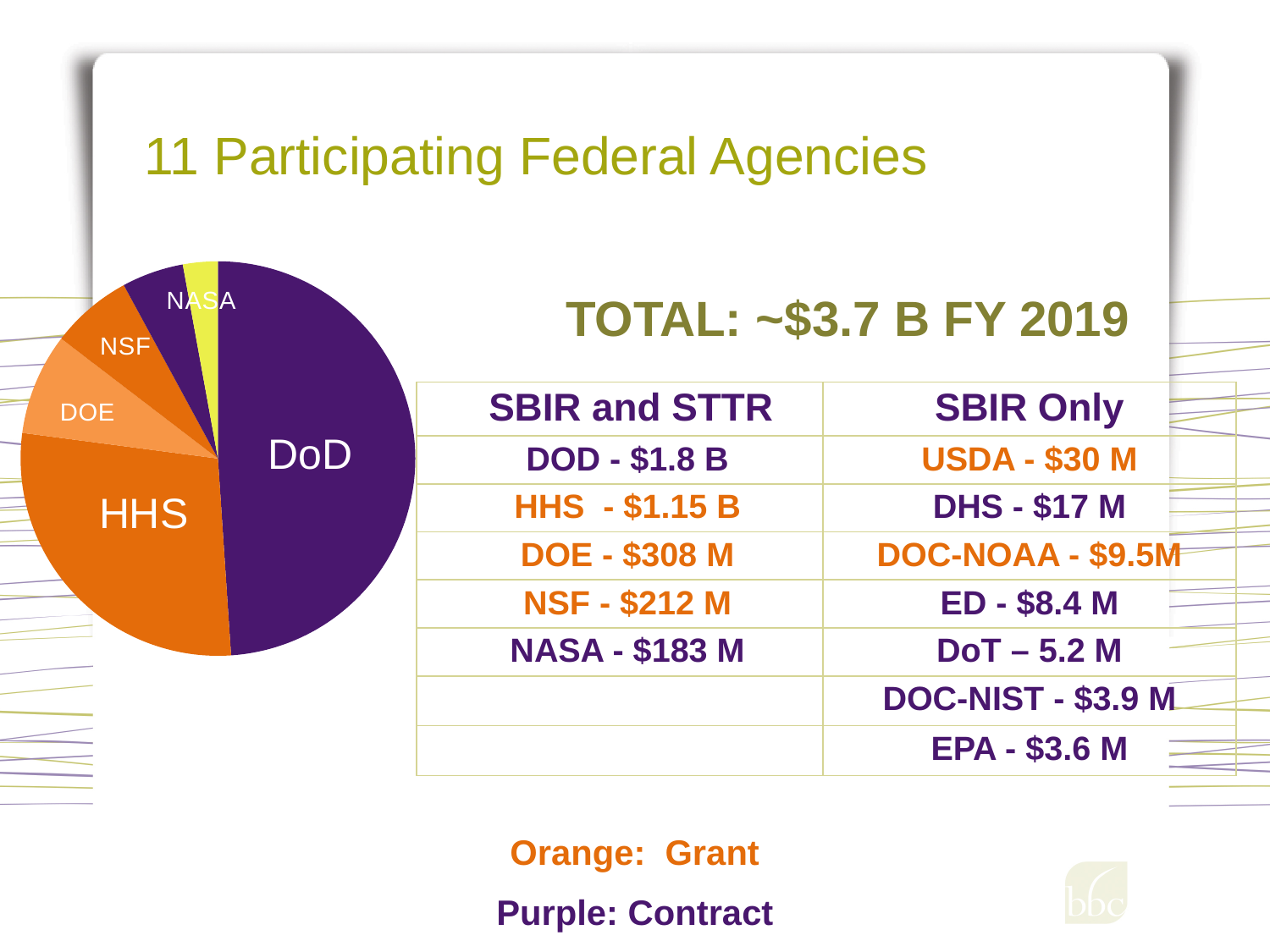
Which slice is larger in the pie chart, HHS or DOE? HHS According to the slide, what is the value for NSF? $212 M According to the slide, what is the value for NASA? $183 M Which slice is larger in the pie chart, DoD or HHS? DoD What kind of chart is shown on the slide? pie chart According to the slide, what is the value for DOD? $1.8 B According to the slide's key, what does the orange colour represent? Grant Which agency has the largest slice of the pie chart? DoD What is the title of the slide containing the pie chart? 11 Participating Federal Agencies According to the slide, what is the value for HHS? $1.15 B What is the difference between the DOE value and the NSF value shown on the slide? $96 M According to the slide, what is the value for DOE? $308 M